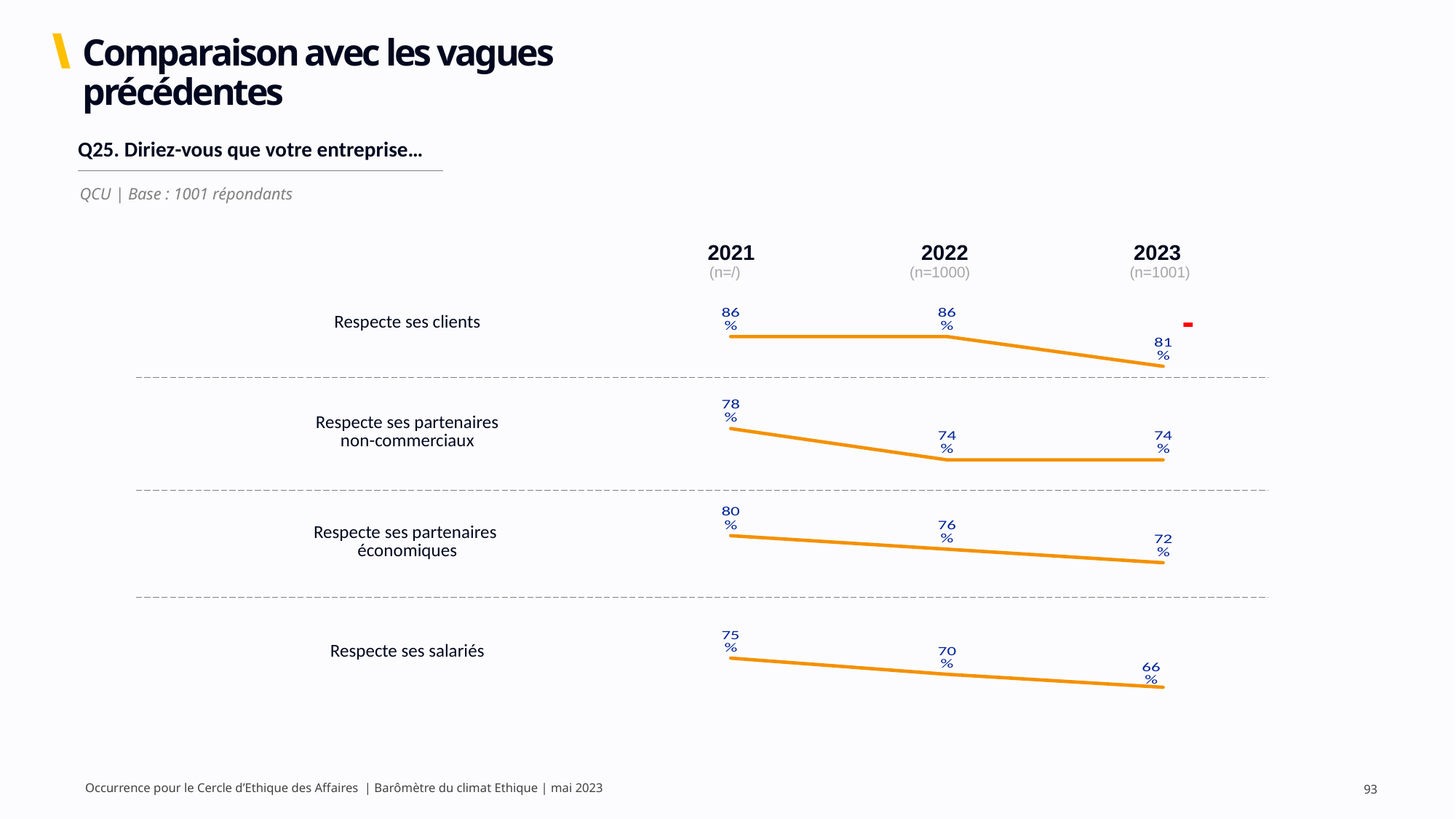
In the 'Respecte ses salariés' chart, which year has the lowest value? 2023 What kind of chart is used for 'Respecte ses salariés'? line chart How many data points does the 'Respecte ses clients' chart show? 3 In the 'Respecte ses partenaires économiques' chart, which year has the highest value? 2021 In the 'Respecte ses clients' chart, what is the difference between the 2022 and 2023 values? 5 percentage points In the 'Respecte ses partenaires non-commerciaux' chart, what is the value for 2023? 74% In the 'Respecte ses partenaires économiques' chart, what is the value for 2022? 76% In the 'Respecte ses salariés' chart, what is the value for 2021? 75% In the 'Respecte ses salariés' chart, what is the difference between the 2021 and 2023 values? 9 percentage points In the 'Respecte ses clients' chart, what is the value for 2023? 81% In the 'Respecte ses partenaires non-commerciaux' chart, is the 2021 value larger or smaller than the 2022 value? larger In the 'Respecte ses partenaires économiques' chart, do the values rise or fall from 2021 to 2023? fall